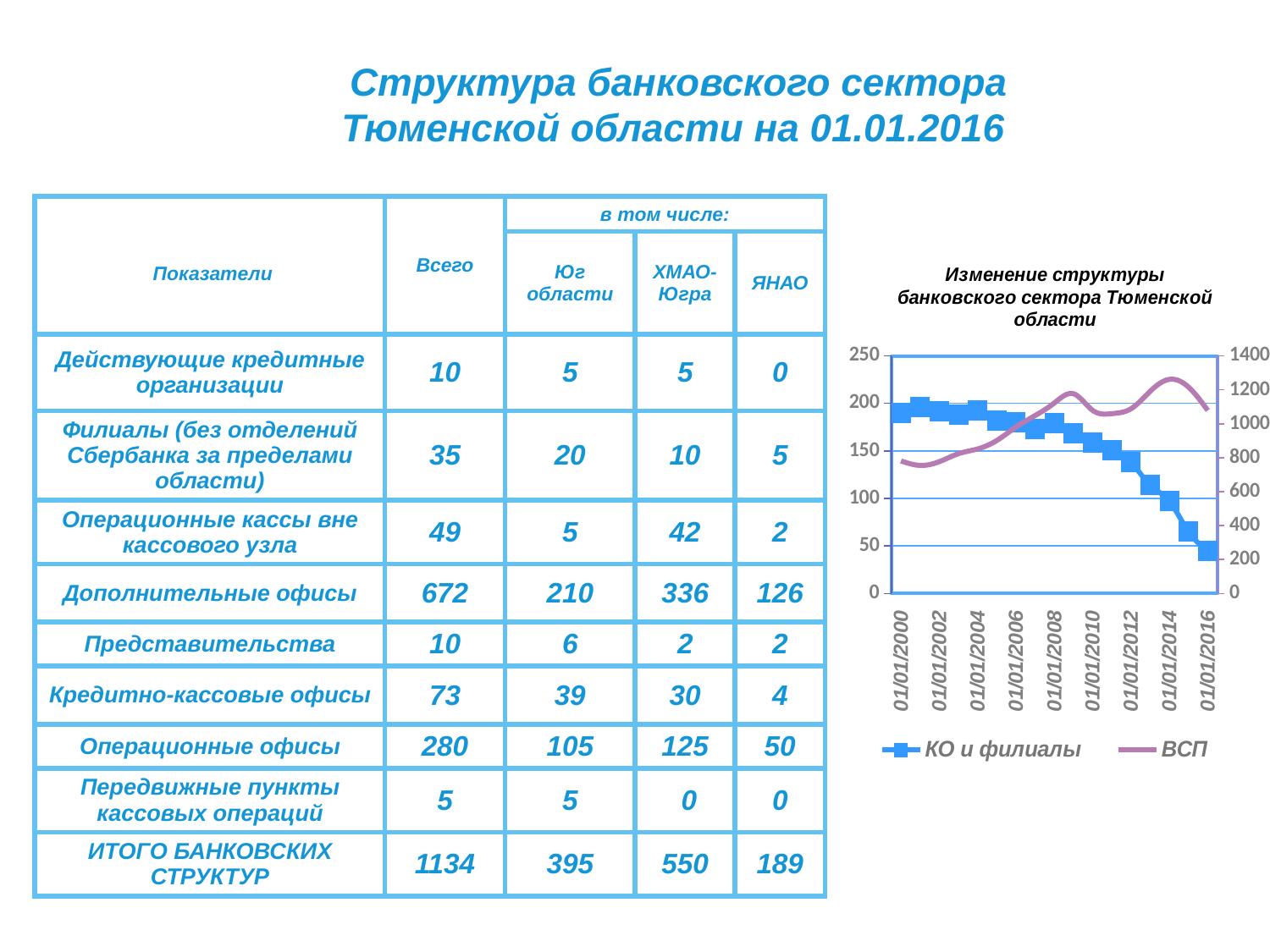
What are the two series named in the chart legend? КО и филиалы and ВСП Does the КО и филиалы series rise or fall from 01/01/2000 to 01/01/2016? fall Does the ВСП series overall rise or fall from 01/01/2000 to 01/01/2016? rise Is the value for КО и филиалы at 01/01/2000 greater or less than 150? greater Is the value for ВСП at 01/01/2016 greater or less than 1000 on the right axis? greater At which date label does the КО и филиалы series reach its lowest value? 01/01/2016 How many date labels are shown on the x axis of the chart? 9 Is the value for ВСП at 01/01/2000 greater or less than 1000 on the right axis? less What is the title of the chart? Изменение структуры банковского сектора Тюменской области What kind of chart is shown on the right side of the slide? line chart How many series does the legend of the chart list? 2